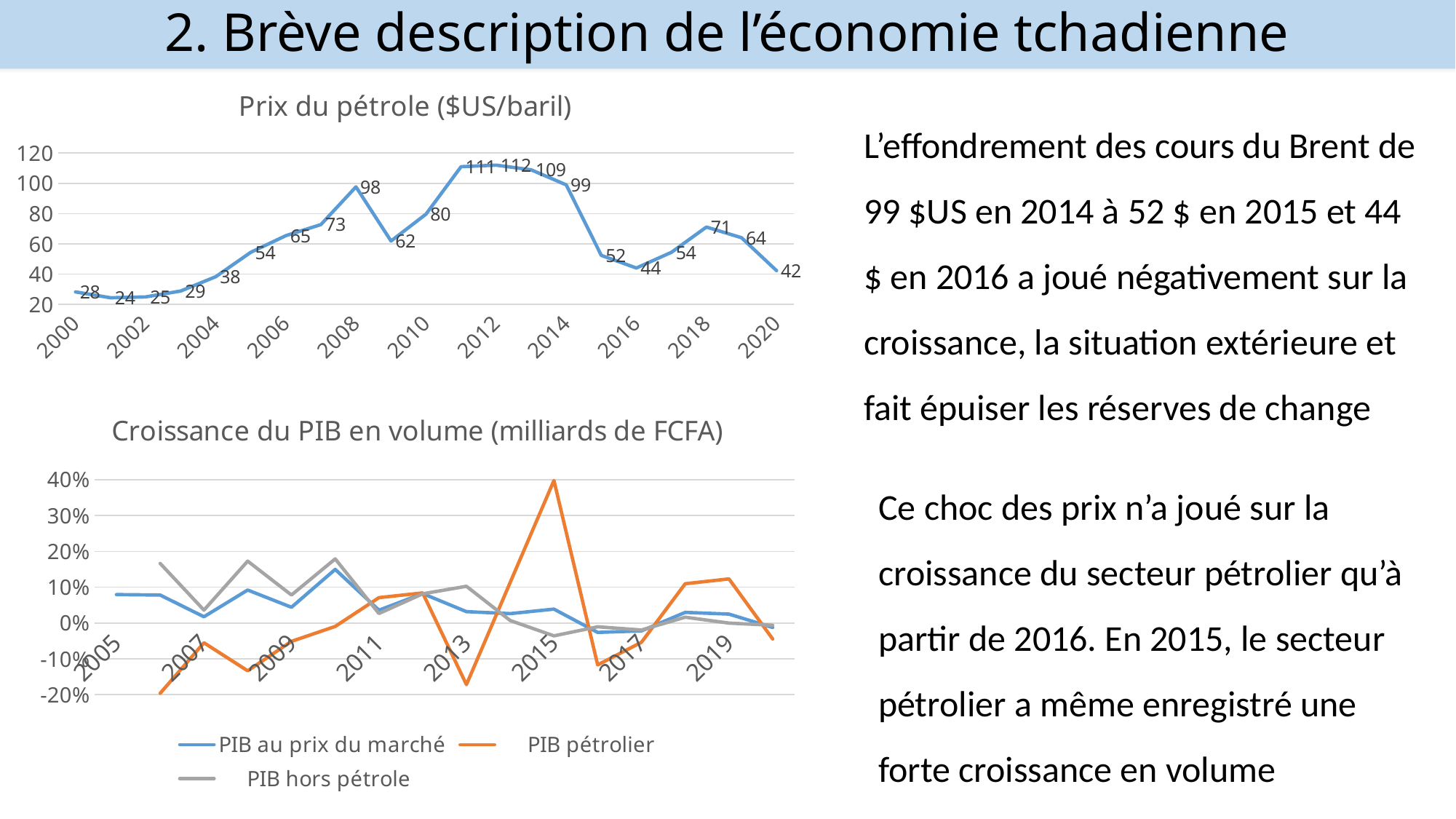
In the chart titled 'Prix du pétrole ($US/baril)', which is larger, the value for 2018 or the value for 2010? 2018 In the chart titled 'Croissance du PIB en volume (milliards de FCFA)', which series is shown in orange? PIB pétrolier In the chart titled 'Prix du pétrole ($US/baril)', which year has the lowest value? 2001 How many series does the legend of the chart titled 'Croissance du PIB en volume (milliards de FCFA)' list? 3 In the chart titled 'Prix du pétrole ($US/baril)', what is the difference between the values for 2014 and 2015? 47 In the chart titled 'Prix du pétrole ($US/baril)', do the values rise or fall between 2012 and 2016? fall In the chart titled 'Croissance du PIB en volume (milliards de FCFA)', is the value for 'PIB pétrolier' in 2015 greater or less than 30%? greater In the chart titled 'Prix du pétrole ($US/baril)', which year has the highest value? 2012 What kind of chart is the one titled 'Croissance du PIB en volume (milliards de FCFA)'? line chart In the chart titled 'Prix du pétrole ($US/baril)', how many data points are plotted? 21 In the chart titled 'Prix du pétrole ($US/baril)', what is the value for 2016? 44 In the chart titled 'Prix du pétrole ($US/baril)', what is the value for 2008? 98